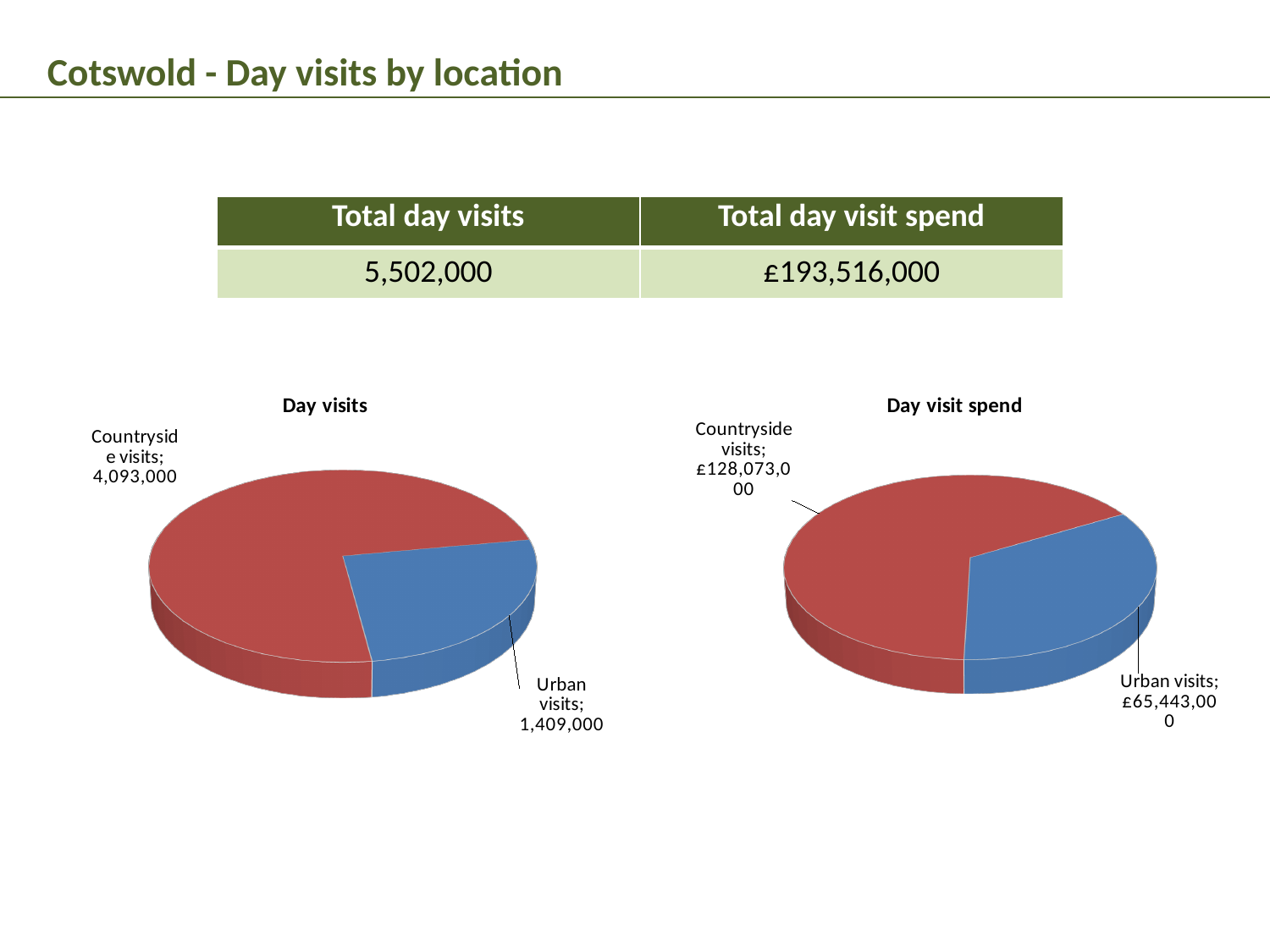
In the Day visits chart, what is the difference between Countryside visits and Urban visits? 2,684,000 In the Day visits chart, what colour is the Urban visits slice? Blue In the Day visit spend chart, what is the value for Urban visits? £65,443,000 In the Day visit spend chart, which category has the smallest slice? Urban visits In the Day visit spend chart, what is the difference between Countryside visits and Urban visits? £62,630,000 In the Day visits chart, what is the value for Urban visits? 1,409,000 What kind of chart is the Day visit spend chart? Pie chart In the Day visit spend chart, which is larger: Countryside visits or Urban visits? Countryside visits In the Day visits chart, which category has the largest slice? Countryside visits In the Day visit spend chart, what is the value for Countryside visits? £128,073,000 In the Day visits chart, what is the value for Countryside visits? 4,093,000 How many slices does the Day visits chart have? 2